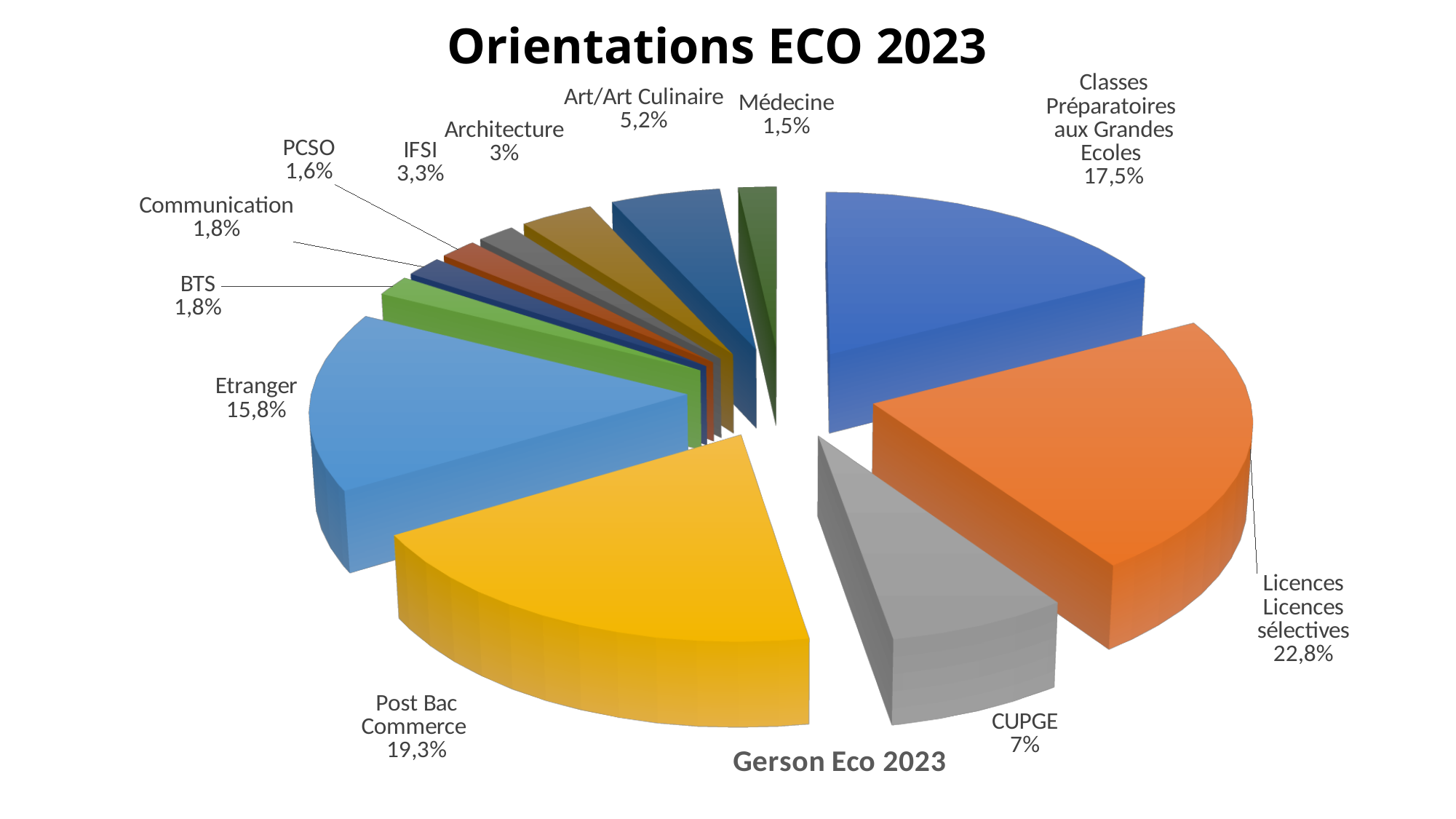
What percentage is shown for CUPGE? 7% What share of the pie does Post Bac Commerce represent? 19,3% How many categories (slices) does the pie chart have? 12 Which category has the smallest share of the pie? Médecine What is the difference in percentage points between Licences Licences sélectives and Post Bac Commerce? 3,5 What percentage is shown for Classes Préparatoires aux Grandes Ecoles? 17,5% What percentage is shown for Etranger? 15,8% What is the difference in percentage points between Architecture and PCSO? 1,4 Which is larger, the share for Art/Art Culinaire or the share for IFSI? Art/Art Culinaire Which category has the largest share of the pie? Licences Licences sélectives What kind of chart is shown on the slide? Pie chart What is the title of the chart? Gerson Eco 2023